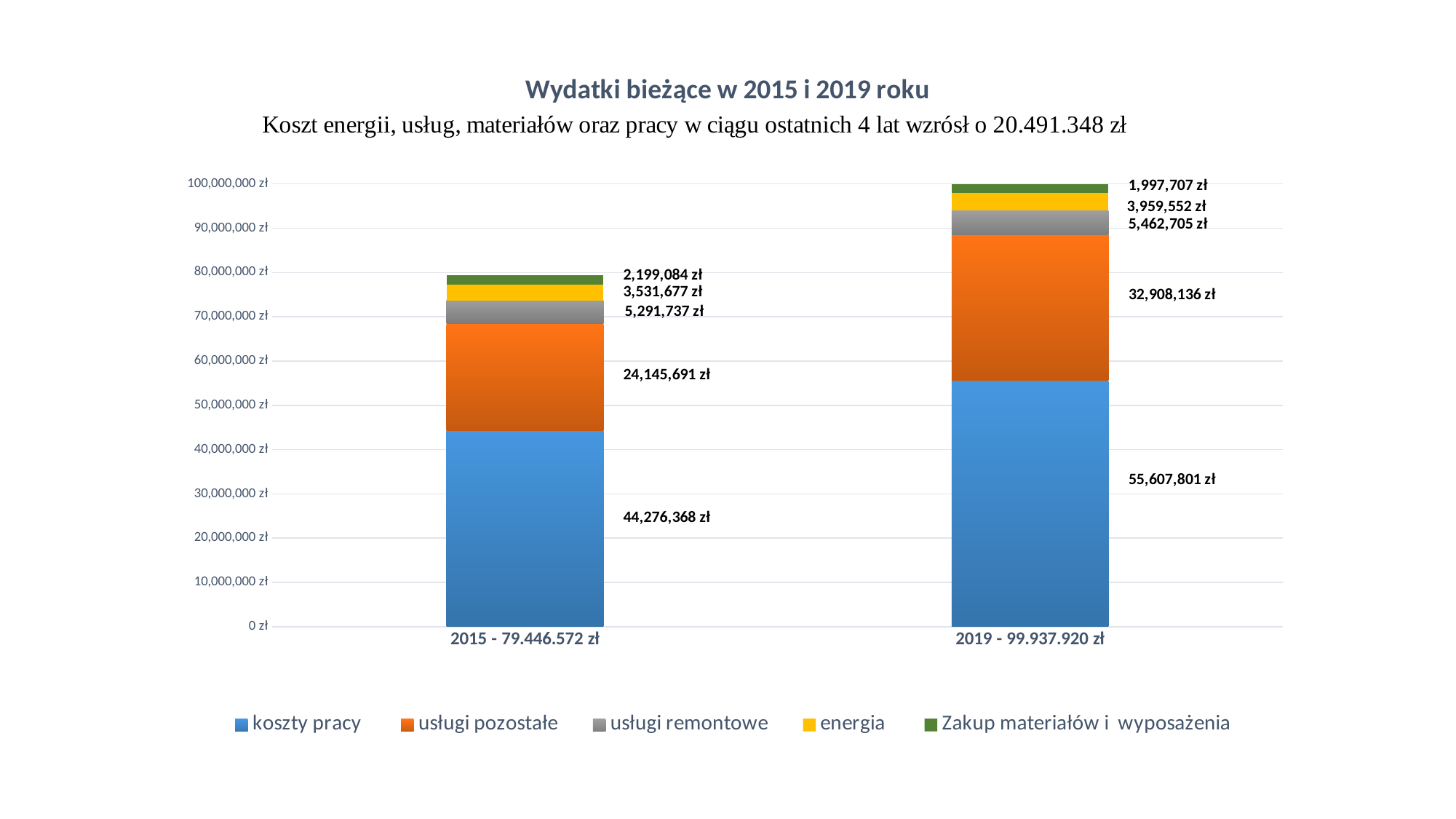
Which year has the larger value for usługi remontowe, 2015 or 2019? 2019 What is the value of energia in 2015? 3,531,677 zł How many bars (years) are plotted in the chart? 2 Which series has the largest value in the 2019 bar? koszty pracy What is the value of Zakup materiałów i wyposażenia in 2019? 1,997,707 zł What is the title of the chart? Wydatki bieżące w 2015 i 2019 roku What kind of chart is shown on the slide? stacked bar chart Which series has the smallest value in the 2015 bar? Zakup materiałów i wyposażenia What is the value of koszty pracy in 2015? 44,276,368 zł How many series does the legend list? 5 What is the value of usługi pozostałe in 2019? 32,908,136 zł By how much did koszty pracy increase from 2015 to 2019? 11,331,433 zł